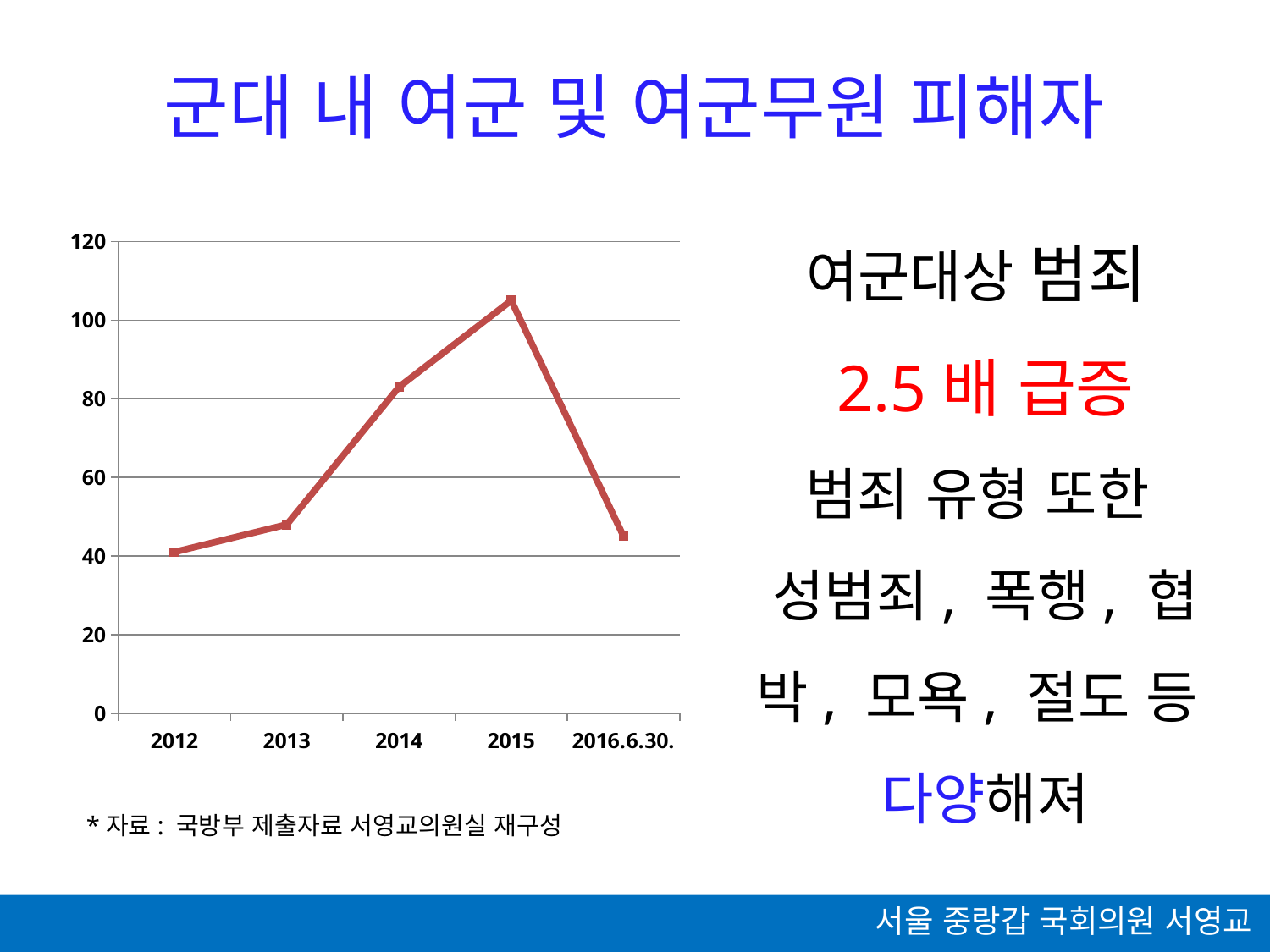
Is the value for 2014 greater or less than 60? greater What kind of chart is shown on the slide? line chart Which year has the highest value on the chart? 2015 Which is larger, the value for 2014 or the value for 2013? 2014 Is the value for 2012 greater or less than 60? less Do the values rise or fall from 2012 to 2015? rise What is the title of the slide containing the chart? 군대 내 여군 및 여군무원 피해자 How many data points are plotted on the line chart? 5 Which is larger, the value for 2015 or the value for 2016.6.30.? 2015 Is the value for 2013 greater or less than 60? less